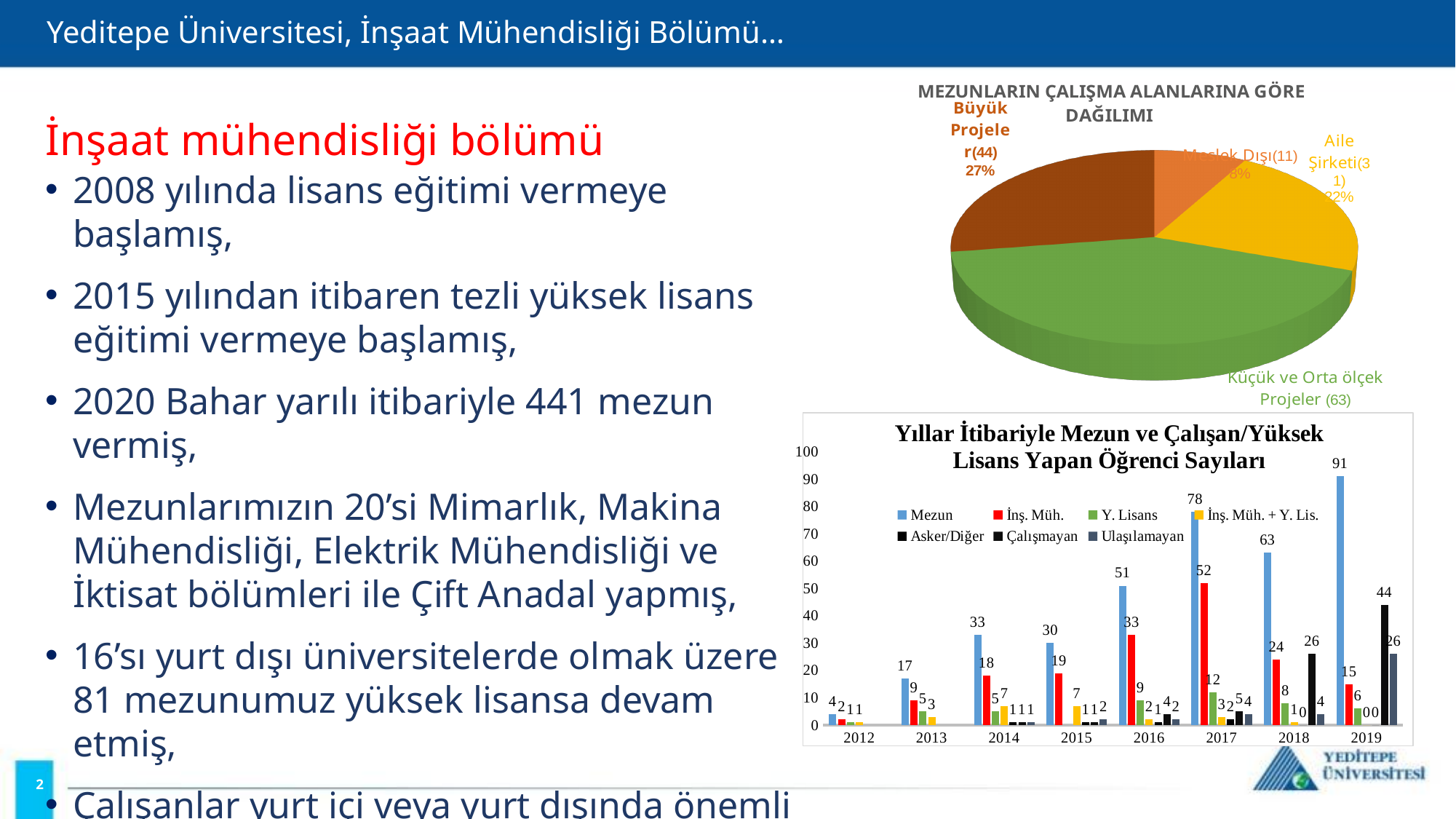
In the bar chart 'Yıllar İtibariyle Mezun ve Çalışan/Yüksek Lisans Yapan Öğrenci Sayıları', which year has the larger İnş. Müh. value, 2017 or 2018? 2017 What kind of chart is the chart titled 'MEZUNLARIN ÇALIŞMA ALANLARINA GÖRE DAĞILIMI'? pie chart In the bar chart 'Yıllar İtibariyle Mezun ve Çalışan/Yüksek Lisans Yapan Öğrenci Sayıları', how many series does the legend list? 7 What kind of chart is the chart titled 'Yıllar İtibariyle Mezun ve Çalışan/Yüksek Lisans Yapan Öğrenci Sayıları'? bar chart In the bar chart 'Yıllar İtibariyle Mezun ve Çalışan/Yüksek Lisans Yapan Öğrenci Sayıları', which year has the highest Mezun value? 2019 In the bar chart 'Yıllar İtibariyle Mezun ve Çalışan/Yüksek Lisans Yapan Öğrenci Sayıları', how many years are shown on the x axis? 8 In the bar chart 'Yıllar İtibariyle Mezun ve Çalışan/Yüksek Lisans Yapan Öğrenci Sayıları', what is the difference between the Mezun values for 2019 and 2018? 28 In the bar chart 'Yıllar İtibariyle Mezun ve Çalışan/Yüksek Lisans Yapan Öğrenci Sayıları', what is the İnş. Müh. value for 2016? 33 In the pie chart 'MEZUNLARIN ÇALIŞMA ALANLARINA GÖRE DAĞILIMI', what share of the pie is Büyük Projeler? 27% In the bar chart 'Yıllar İtibariyle Mezun ve Çalışan/Yüksek Lisans Yapan Öğrenci Sayıları', does the Mezun value rise or fall from 2012 to 2014? rise In the pie chart 'MEZUNLARIN ÇALIŞMA ALANLARINA GÖRE DAĞILIMI', which slice is the largest? Küçük ve Orta ölçek Projeler In the bar chart 'Yıllar İtibariyle Mezun ve Çalışan/Yüksek Lisans Yapan Öğrenci Sayıları', what is the Mezun value for 2019? 91